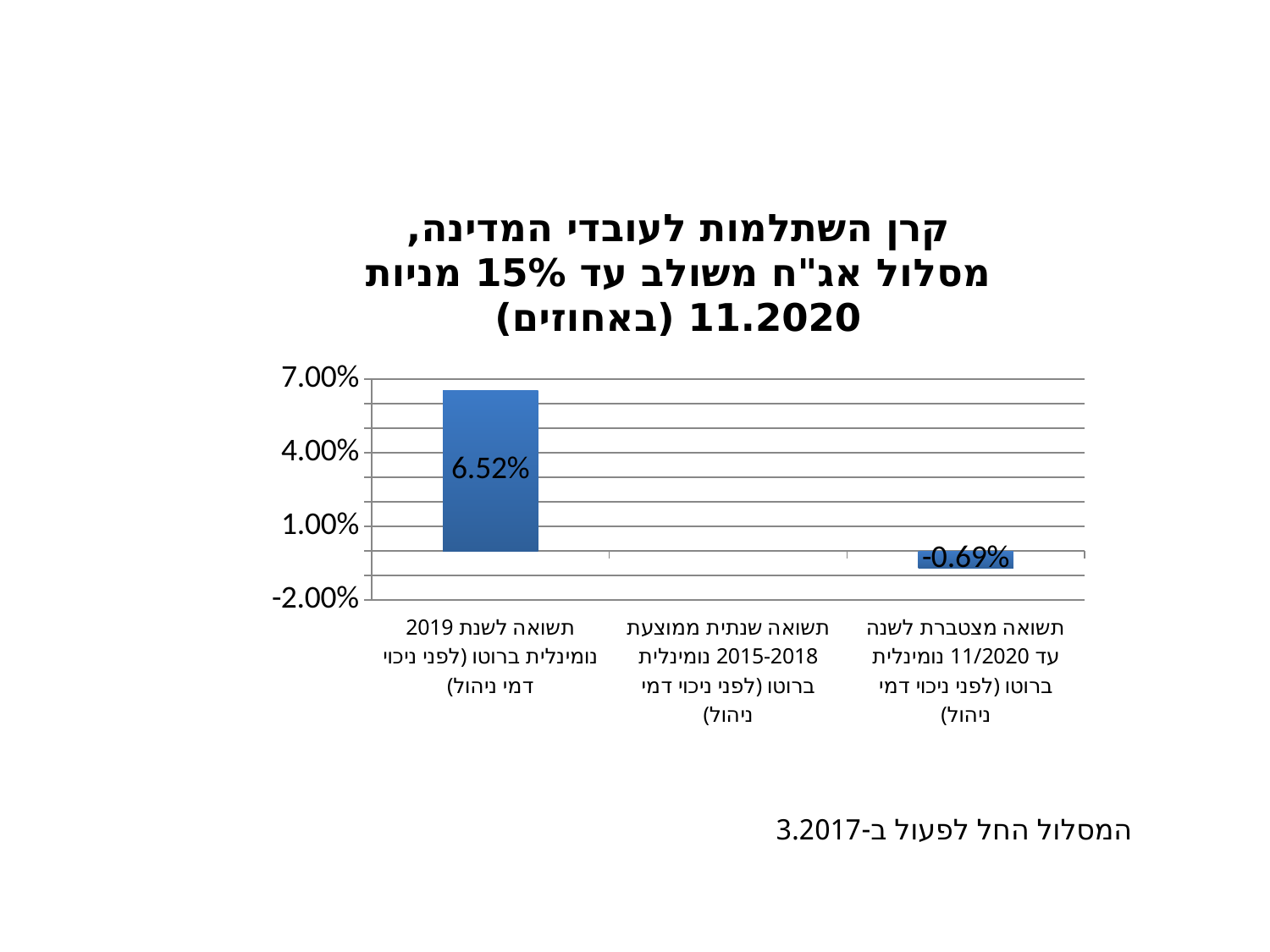
What is the value for the 2019 nominal gross return (תשואה לשנת 2019 נומינלית ברוטו)? 6.52% Which category has the highest value? תשואה לשנת 2019 נומינלית ברוטו (לפני ניכוי דמי ניהול) What is the value for the cumulative return for the year to 11/2020 (תשואה מצטברת לשנה עד 11/2020)? -0.69% How many categories are shown on the x axis? 3 Which category has the lowest plotted value? תשואה מצטברת לשנה עד 11/2020 נומינלית ברוטו (לפני ניכוי דמי ניהול) What is the difference between the 2019 return (6.52%) and the cumulative return to 11/2020 (-0.69%)? 7.21 percentage points What kind of chart is shown on the slide? Bar chart Is the value for the 2019 return greater or less than 4.00%? greater According to the note below the chart, when did the track start operating? 3.2017 Which is larger: the 2019 return or the cumulative return to 11/2020? The 2019 return Which category has no bar plotted? תשואה שנתית ממוצעת 2015-2018 נומינלית ברוטו (לפני ניכוי דמי ניהול)